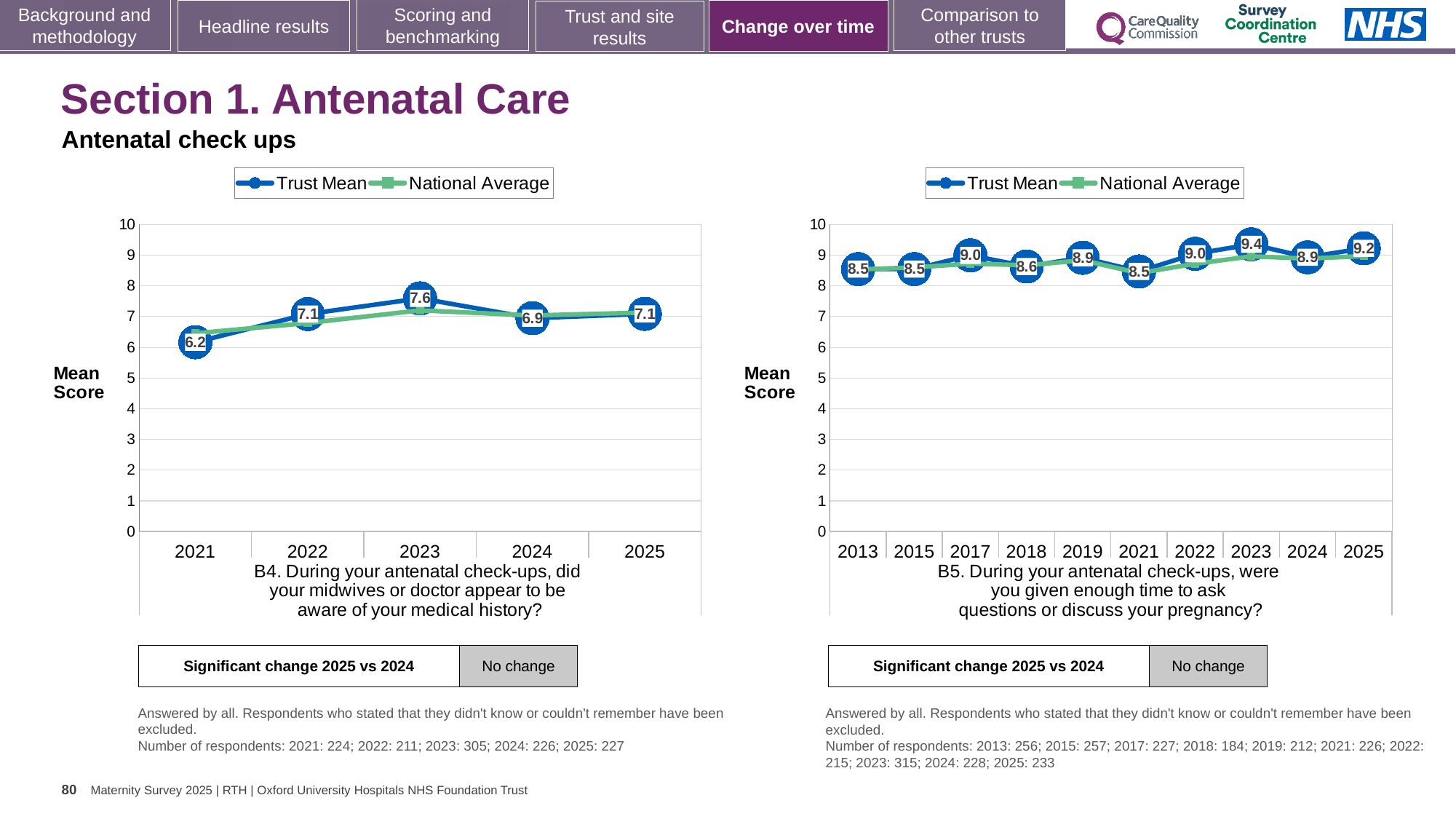
In the right chart (B5), which year has the highest Trust Mean score? 2023 In the left chart (B4), what is the difference between the Trust Mean scores for 2023 and 2021? 1.4 In the left chart (B4), what is the Trust Mean score for 2023? 7.6 In the left chart (B4), which year has the lowest Trust Mean score? 2021 In the right chart (B5), what is the Trust Mean score for 2018? 8.6 In the left chart (B4), which year has the highest Trust Mean score? 2023 In the right chart (B5), how many series does the legend list? 2 In the left chart (B4), what is the Trust Mean score for 2021? 6.2 In the right chart (B5), what is the Trust Mean score for 2023? 9.4 In the left chart (B4), how many years are shown on the x axis? 5 In the right chart (B5), is the Trust Mean score for 2025 larger or smaller than for 2024? larger What kind of chart is the right chart (B5)? line chart